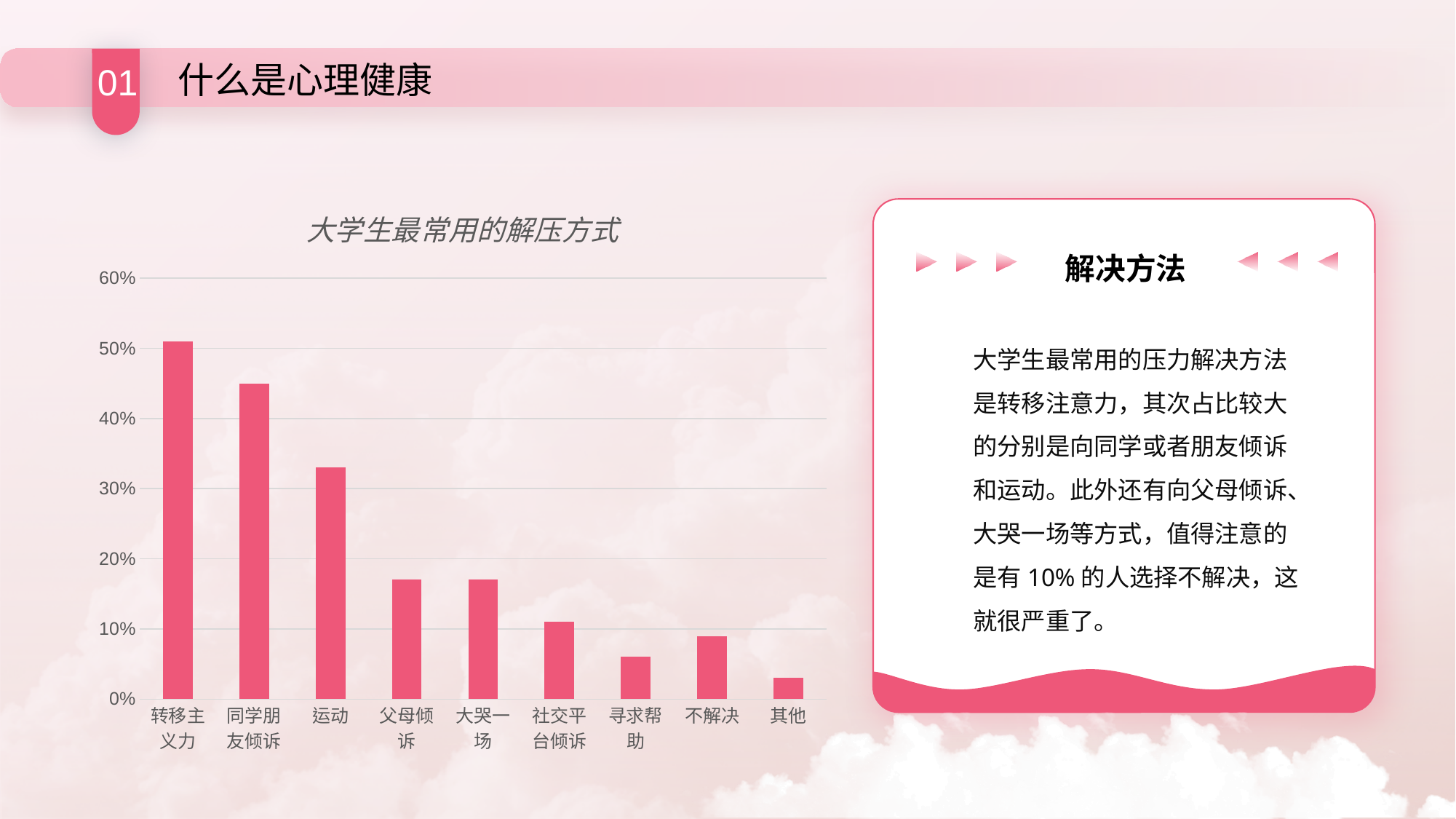
What kind of chart is shown on the slide? bar chart Is the value for 其他 greater or less than 10%? less Is the value for 运动 greater or less than 30%? greater Which is larger, the value for 运动 or the value for 父母倾诉? 运动 Which category has the highest value in the chart? 转移主义力 What is the title of the chart? 大学生最常用的解压方式 Do the values generally rise or fall moving from left to right along the x axis? fall Is the value for 同学朋友倾诉 greater or less than 40%? greater Which is larger, the value for 寻求帮助 or the value for 不解决? 不解决 Which category has the lowest value in the chart? 其他 How many categories are shown on the x axis of the chart? 9